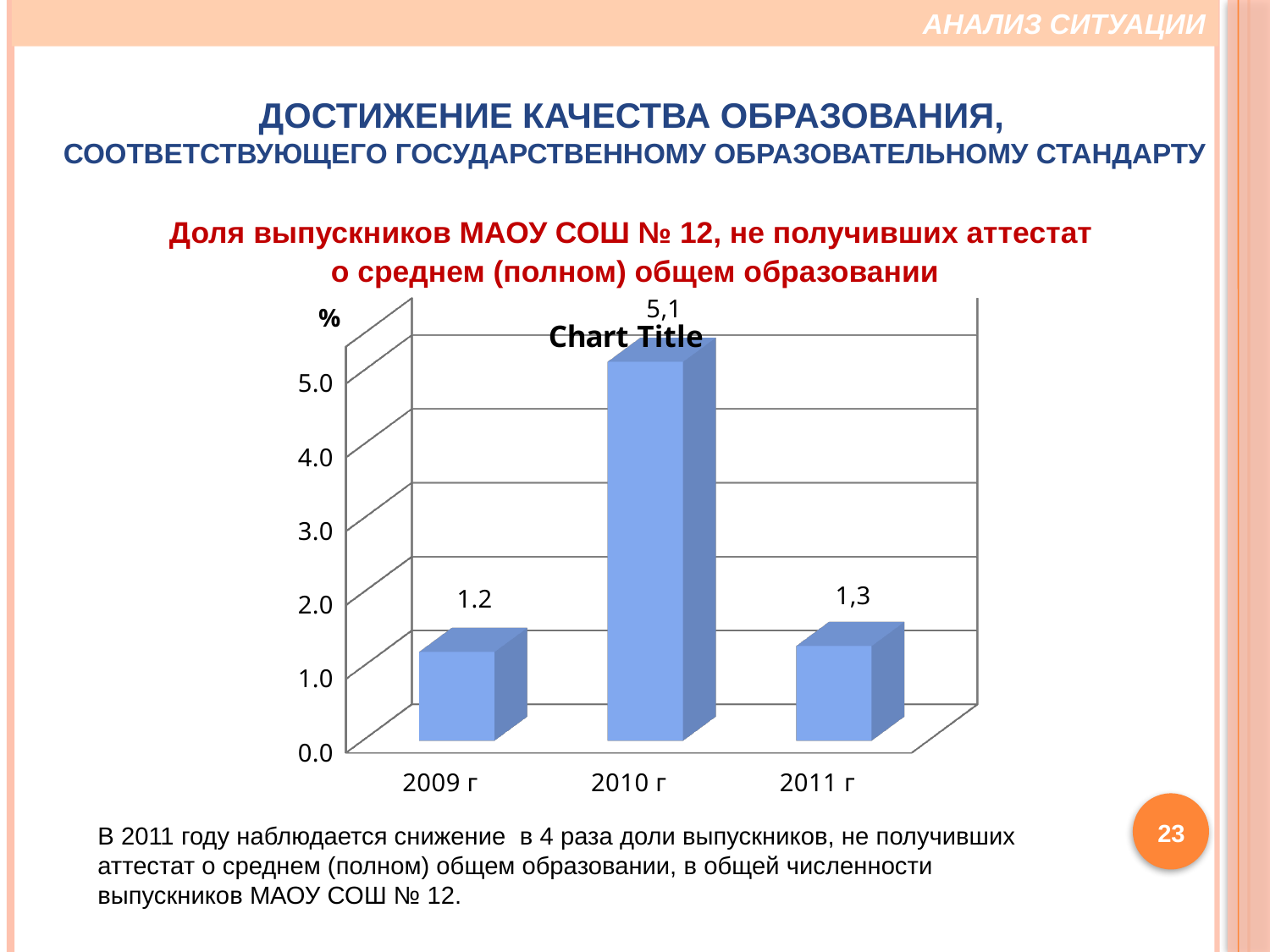
What is the value for 2010 г? 5,1 Which is larger, the value for 2010 г or the value for 2009 г? 2010 г What unit label is shown at the top of the vertical axis? % What kind of chart is shown on the slide? bar chart Which year has the lowest value? 2009 г Is the value for 2010 г greater or less than 4.0? greater What is the value for 2009 г? 1.2 How many years are shown on the x axis? 3 Which year has the highest value? 2010 г What is the difference between the values for 2010 г and 2011 г? 3,8 What is the value for 2011 г? 1,3 Is the value for 2011 г greater or less than 2.0? less